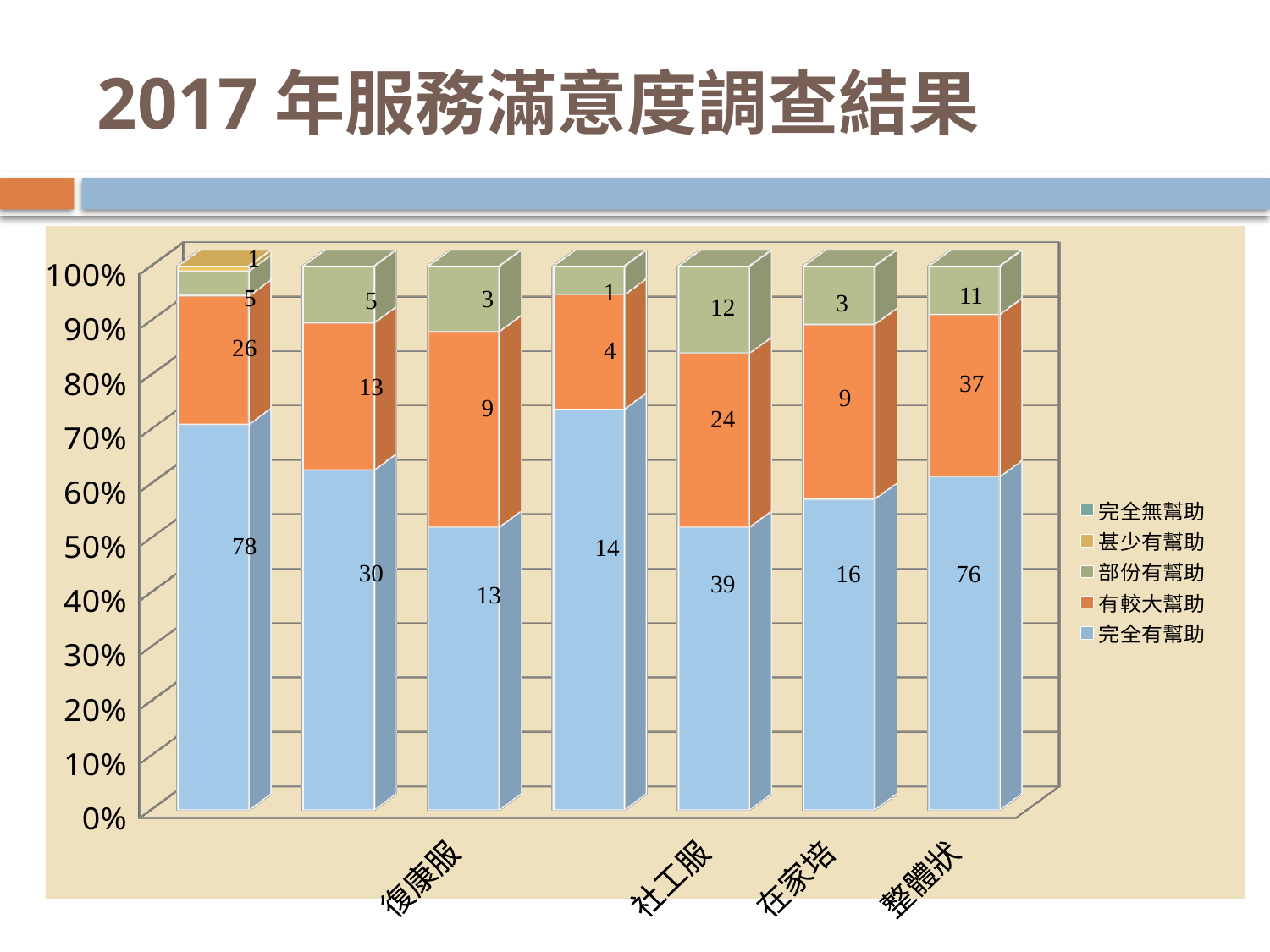
What kind of chart is shown on the slide? Stacked bar chart On the last (rightmost) bar, what is the difference between the 完全有幫助 value and the 有較大幫助 value? 39 Which series is shown in blue according to the legend? 完全有幫助 How many series does the legend list? 5 What is the 甚少有幫助 value labelled on the first (leftmost) bar? 1 What is the 完全有幫助 value labelled on the first (leftmost) bar? 78 What is the 有較大幫助 value labelled on the last (rightmost) bar? 37 Which is larger: the 有較大幫助 value on the first bar or on the fifth bar? The first bar Which bar has the highest labelled 完全有幫助 value? The first (leftmost) bar How many bars are plotted in the chart? 7 What is the total of the labelled values on the first (leftmost) bar? 110 What is the 部份有幫助 value labelled on the fifth bar from the left? 12